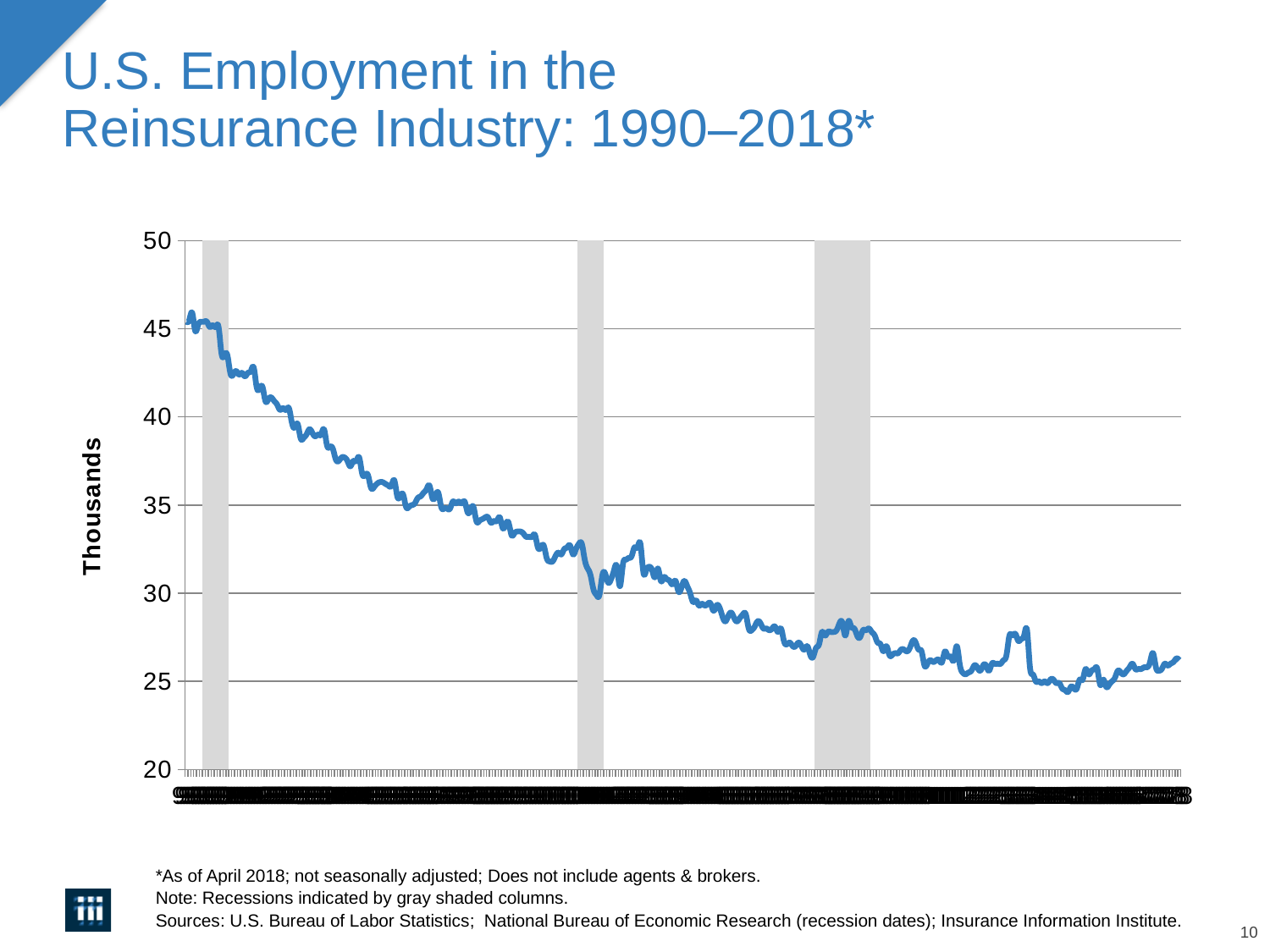
Overall, do the values rise or fall from left to right along the x axis? Fall Is the value at the end of the series (right end of the line) greater or less than 25? greater Is the value of the line inside the middle gray shaded column greater or less than 35? less What is the highest value shown on the vertical axis of the chart? 50 What is the label on the vertical axis of the chart? Thousands Is the value at the end of the series (right end of the line) greater or less than 30? less What is the title of the chart on the slide? U.S. Employment in the Reinsurance Industry: 1990–2018* Which is larger, the value at the start of the series or the value at the end of the series? The value at the start Is the highest point of the line at the left end or the right end of the chart? Left end How many gray shaded recession columns are shown on the chart? 3 What kind of chart is shown on the slide? Line chart